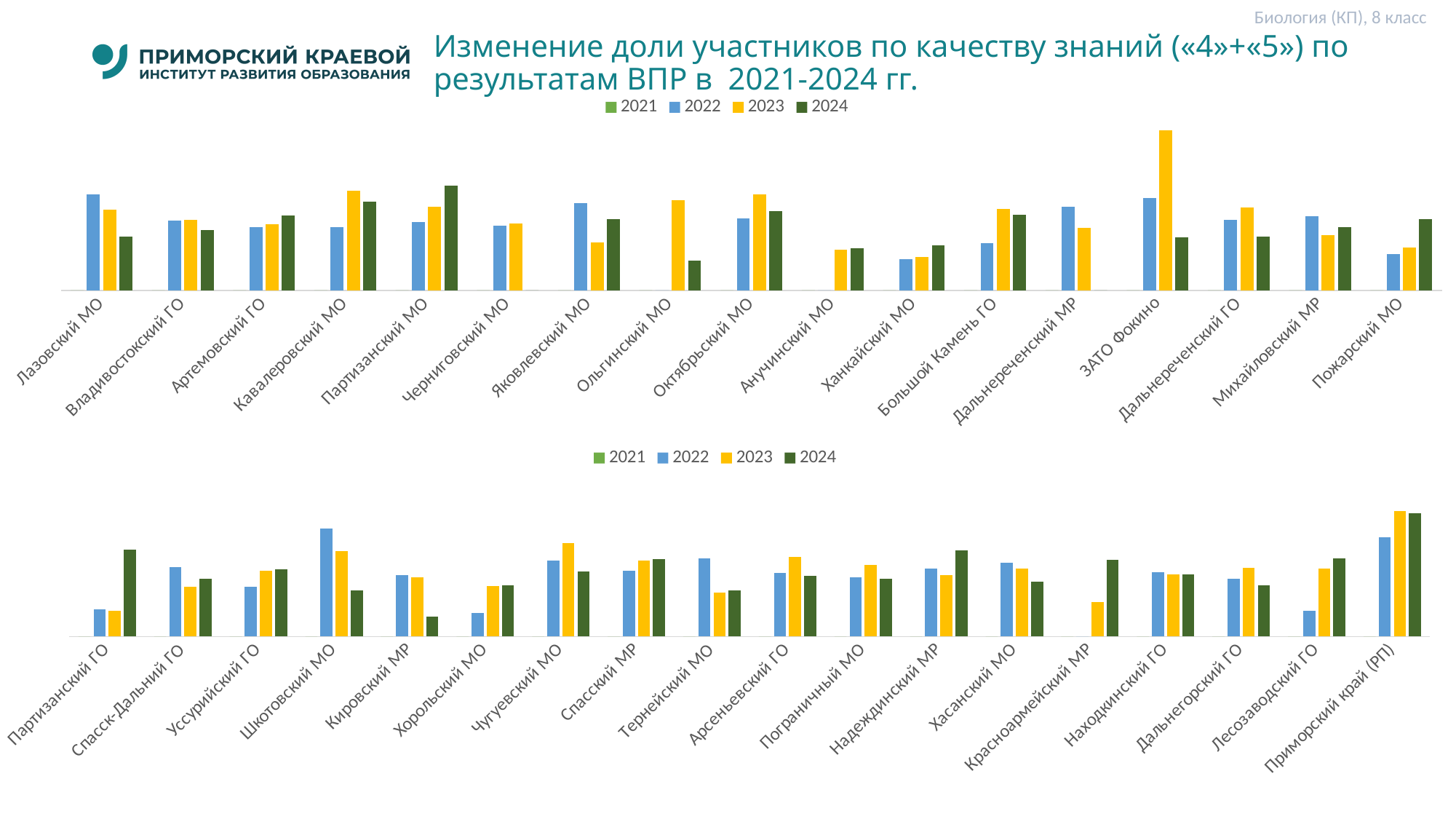
In the bottom chart, for Партизанский ГО, which is larger: the 2022 bar or the 2024 bar? 2024 Which legend series has no visible bars in either chart? 2021 In the top chart, do the bars for Партизанский МО rise or fall from 2022 to 2024? rise In the bottom chart, which category has the tallest bar? Приморский край (РП) In the bottom chart, do the bars for Кировский МР rise or fall from 2022 to 2024? fall In the top chart, for Ольгинский МО, which is larger: the 2023 bar or the 2024 bar? 2023 How many categories are shown on the x axis of the top chart? 17 How many series does the legend of the top chart list? 4 In the top chart, for Лазовский МО, which is larger: the 2022 bar or the 2024 bar? 2022 How many categories are shown on the x axis of the bottom chart? 18 What kind of chart is the top chart on the slide? bar chart In the top chart, which category has the tallest bar? ЗАТО Фокино